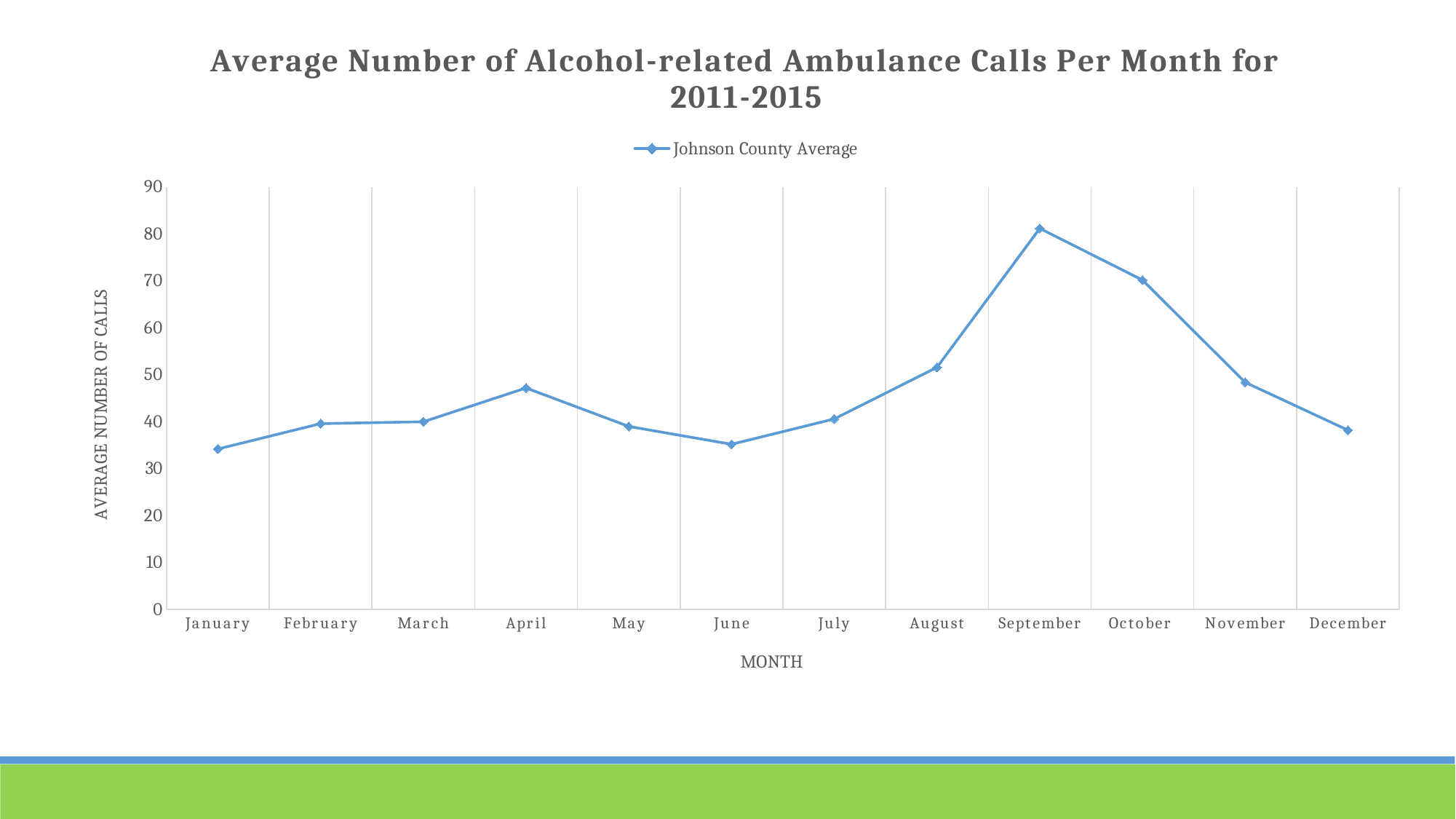
How many months are plotted along the x axis? 12 What kind of chart is shown on the slide? line chart Is the value for April greater or less than 40? greater Is the value for June greater or less than 40? less Which is larger, the value for September or the value for October? September Is the value for January greater or less than 40? less Which month has the highest Johnson County Average of alcohol-related ambulance calls? September Which is larger, the value for April or the value for May? April Do the values rise or fall from September to December? fall How many series does the legend list? 1